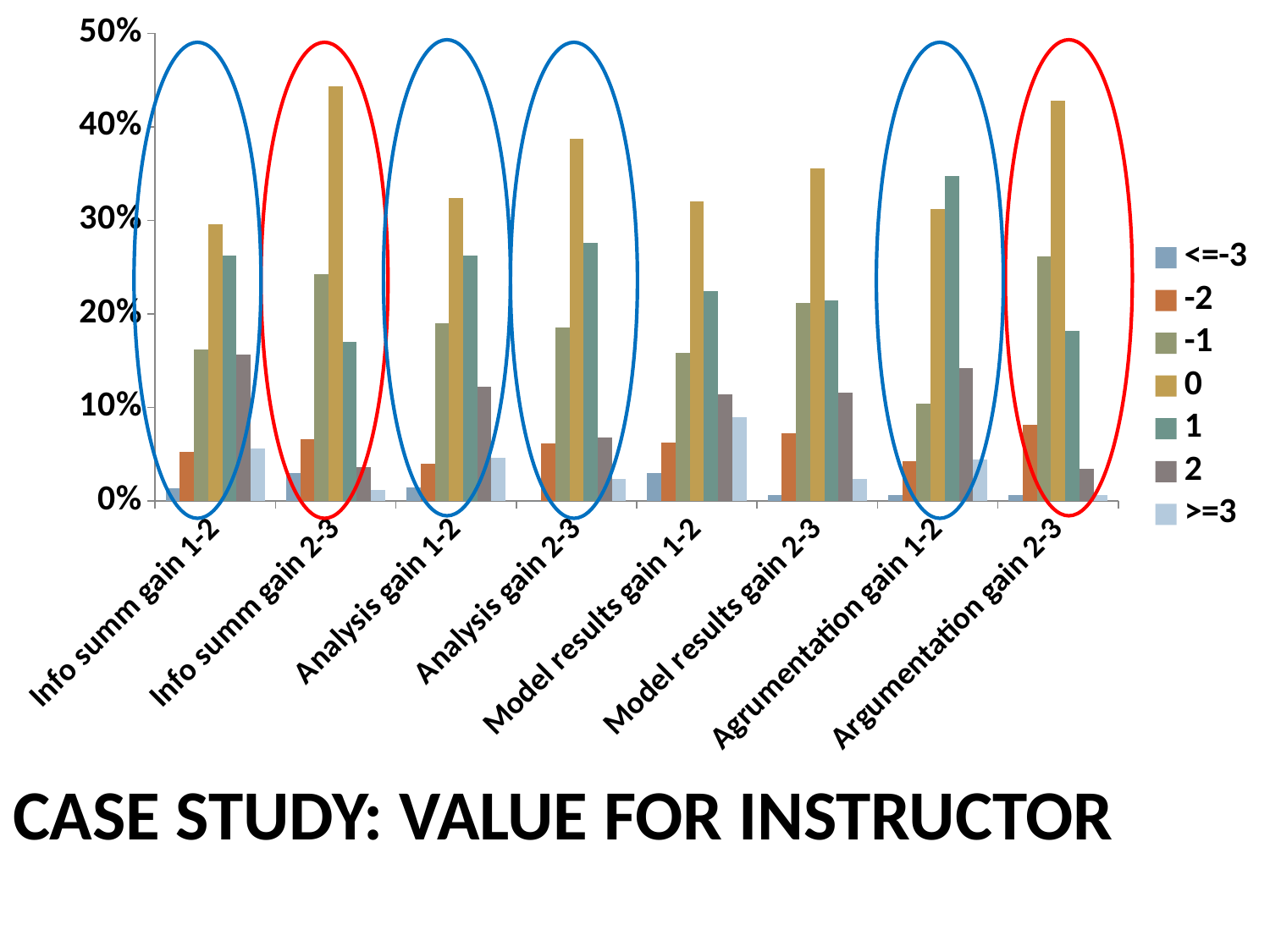
How many categories are shown along the x axis of the chart? 8 Is the value of the "1" series for Argumentation gain 1-2 greater or less than 30%? greater For Info summ gain 2-3, which is larger: the "-1" series or the "0" series? 0 Which series has the tallest bar for Info summ gain 2-3? 0 What kind of chart is shown on the slide? bar chart Is the value of the "-2" series for Model results gain 1-2 greater or less than 10%? less Is the value of the "0" series for Info summ gain 2-3 greater or less than 40%? greater How many of the ellipses drawn over the chart are red? 2 How many series does the chart's legend list? 7 For Argumentation gain 1-2, which is larger: the "0" series or the "1" series? 1